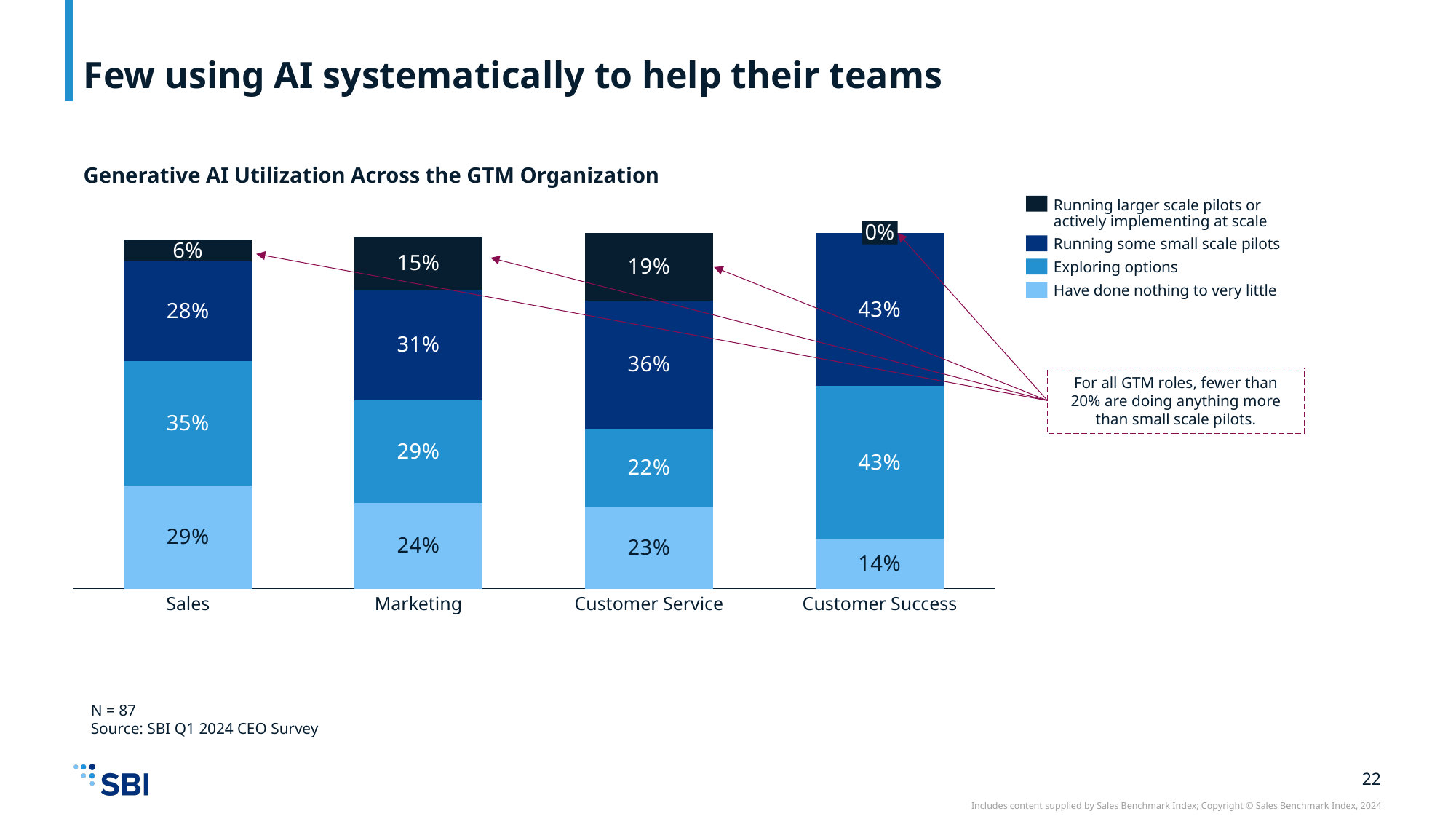
How many categories are shown on the x axis? 4 What is the difference between the 'Running some small scale pilots' values for Customer Success and Sales? 15% What percentage of Sales is 'Running larger scale pilots or actively implementing at scale'? 6% Which category has the highest 'Running larger scale pilots or actively implementing at scale' value? Customer Service Which is larger: the 'Exploring options' value for Sales or for Marketing? Sales Which category has the lowest 'Have done nothing to very little' value? Customer Success How many series does the legend list? 4 What type of chart is shown on the slide? Stacked bar chart What is the total of the stacked bar for Customer Service? 100% What is the 'Have done nothing to very little' value for Customer Success? 14% What is the title of the chart? Generative AI Utilization Across the GTM Organization What is the 'Exploring options' value for Customer Service? 22%